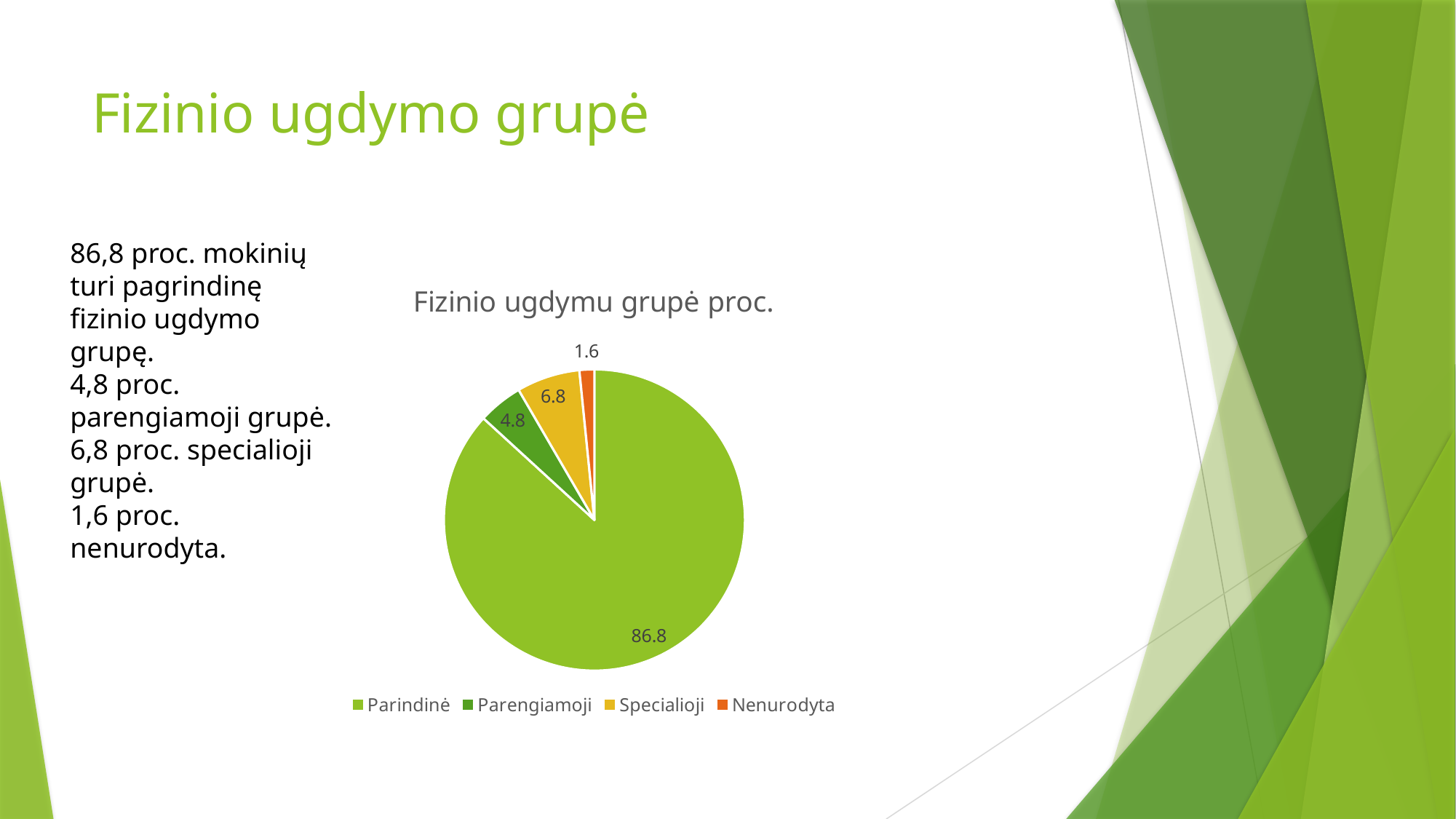
Which category has the smallest slice of the pie chart? Nenurodyta What is the value for Nenurodyta in the pie chart? 1.6 What colour is the Specialioji slice in the pie chart? Yellow What is the title of the chart? Fizinio ugdymu grupė proc. What is the value for Parindinė in the pie chart? 86.8 What is the difference between the values for Specialioji and Parengiamoji? 2 Which category has the largest slice of the pie chart? Parindinė What kind of chart is shown on the slide? Pie chart What is the value for Specialioji in the pie chart? 6.8 How many categories are shown in the pie chart? 4 Which is larger, the value for Specialioji or the value for Parengiamoji? Specialioji What is the value for Parengiamoji in the pie chart? 4.8